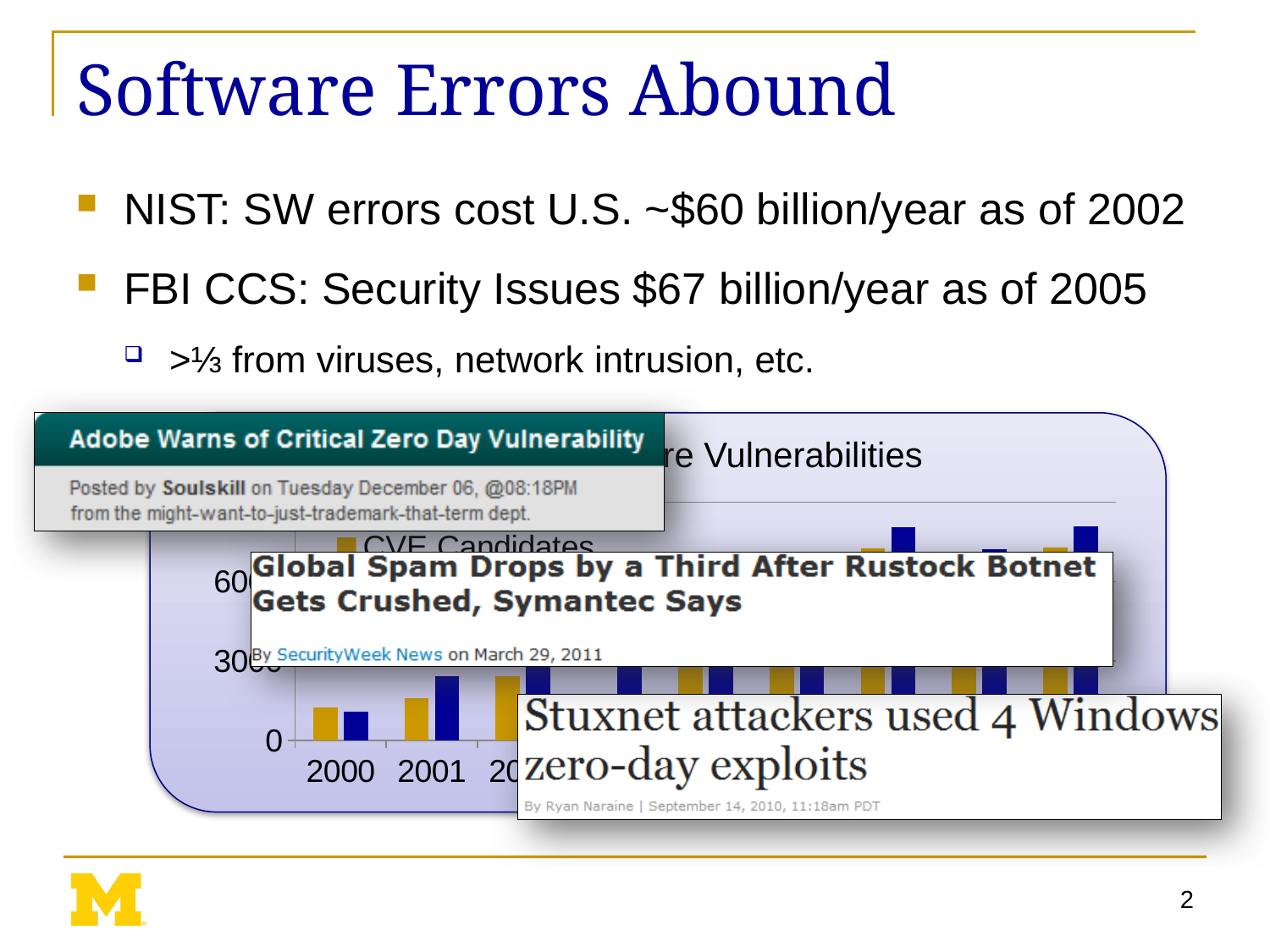
What is the first year label shown on the x axis? 2000 Do the bar values rise or fall from 2000 to 2001? rise What kind of chart is shown on the slide? bar chart Which year has the taller gold bar, 2000 or 2001? 2001 Which year has the taller blue bar, 2000 or 2001? 2001 Which legend entry is readable on the chart? CVE Candidates In 2001, which bar is taller, the gold bar or the blue bar? the blue bar